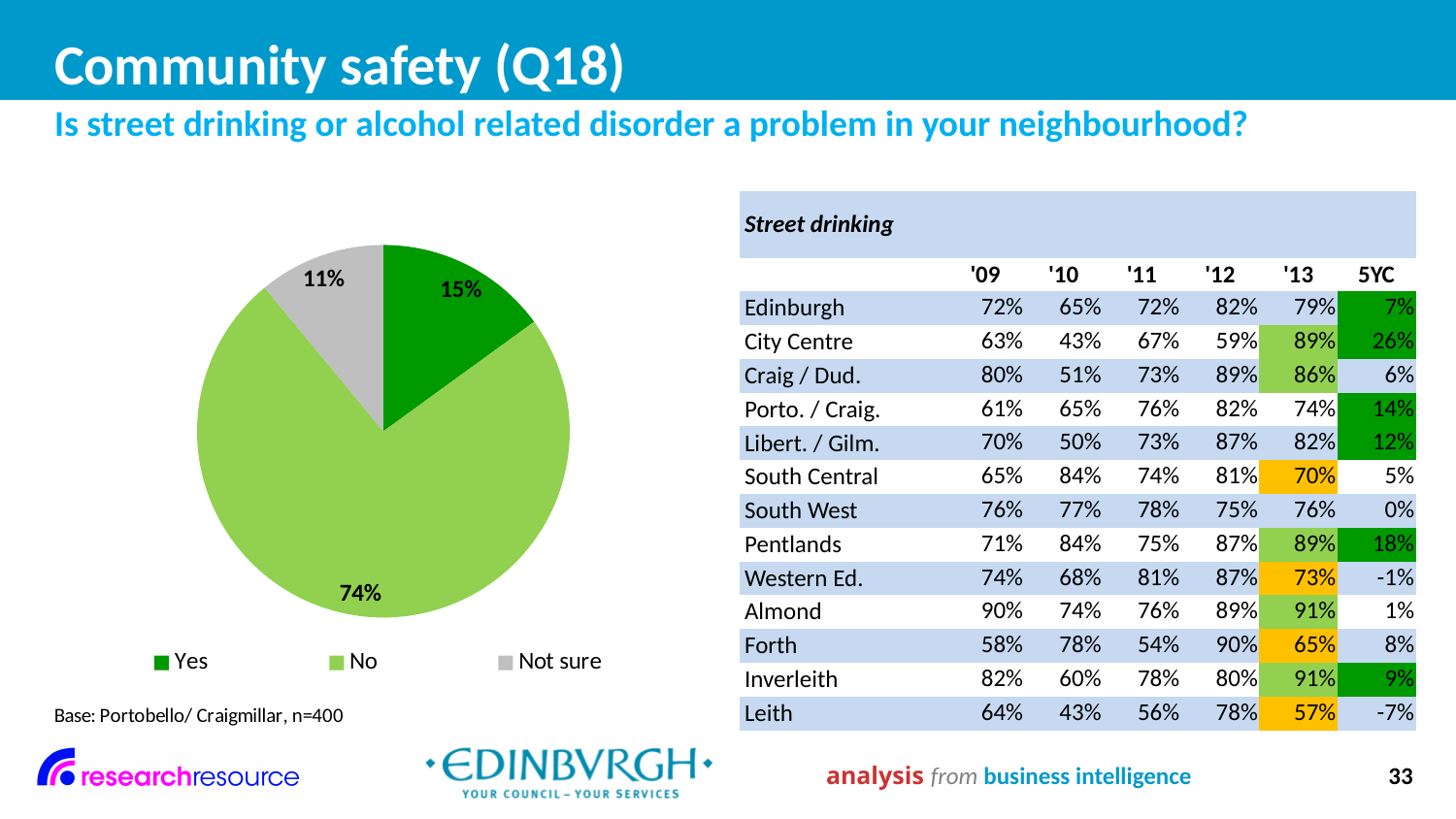
What percentage of respondents answered "Not sure" in the pie chart? 11% What kind of chart is shown on the slide? pie chart What is the difference in percentage points between the "No" and "Yes" slices? 59 Which response has the smallest slice in the pie chart? Not sure What percentage of respondents answered "Yes" in the pie chart? 15% What colour is the "Not sure" slice in the pie chart? grey How many entries does the pie chart legend list? 3 Which response has the largest slice in the pie chart? No What percentage of respondents answered "No" in the pie chart? 74% What is the base (sample size) stated for the pie chart? Portobello/ Craigmillar, n=400 How many slices does the pie chart have? 3 Which slice is larger in the pie chart, "Yes" or "Not sure"? Yes